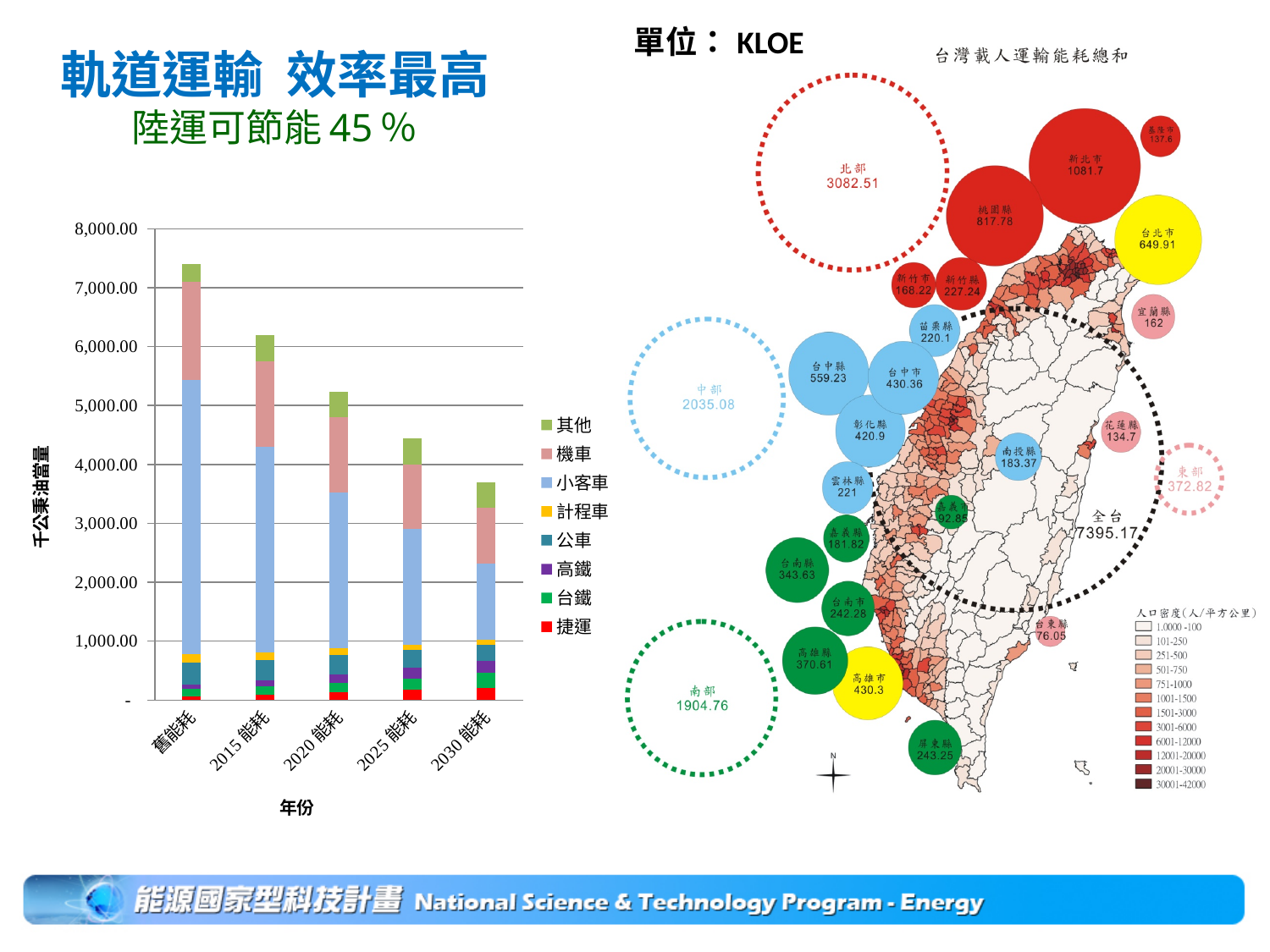
In the bar chart on the left, how many series does the legend list? 8 In the bar chart on the left, which category has the tallest stacked bar? 舊能耗 In the bar chart on the left, is the total for 2020能耗 greater or less than 5,000.00? greater What kind of chart is the chart on the left of the slide? bar chart In the bar chart on the left, do the total bar heights rise or fall from 舊能耗 to 2030能耗? fall In the bubble map on the right, what value is printed for 全台? 7395.17 In the bar chart on the left, is the total for 2030能耗 greater or less than 4,000.00? less In the bar chart on the left, which stacked bar is taller, 2015能耗 or 2025能耗? 2015能耗 In the bar chart on the left, what is the title of the y axis? 千公秉油當量 In the bar chart on the left, how many categories are shown on the x axis? 5 In the bar chart on the left, which category has the shortest stacked bar? 2030能耗 In the bar chart on the left, is the total for 舊能耗 greater or less than 7,000.00? greater